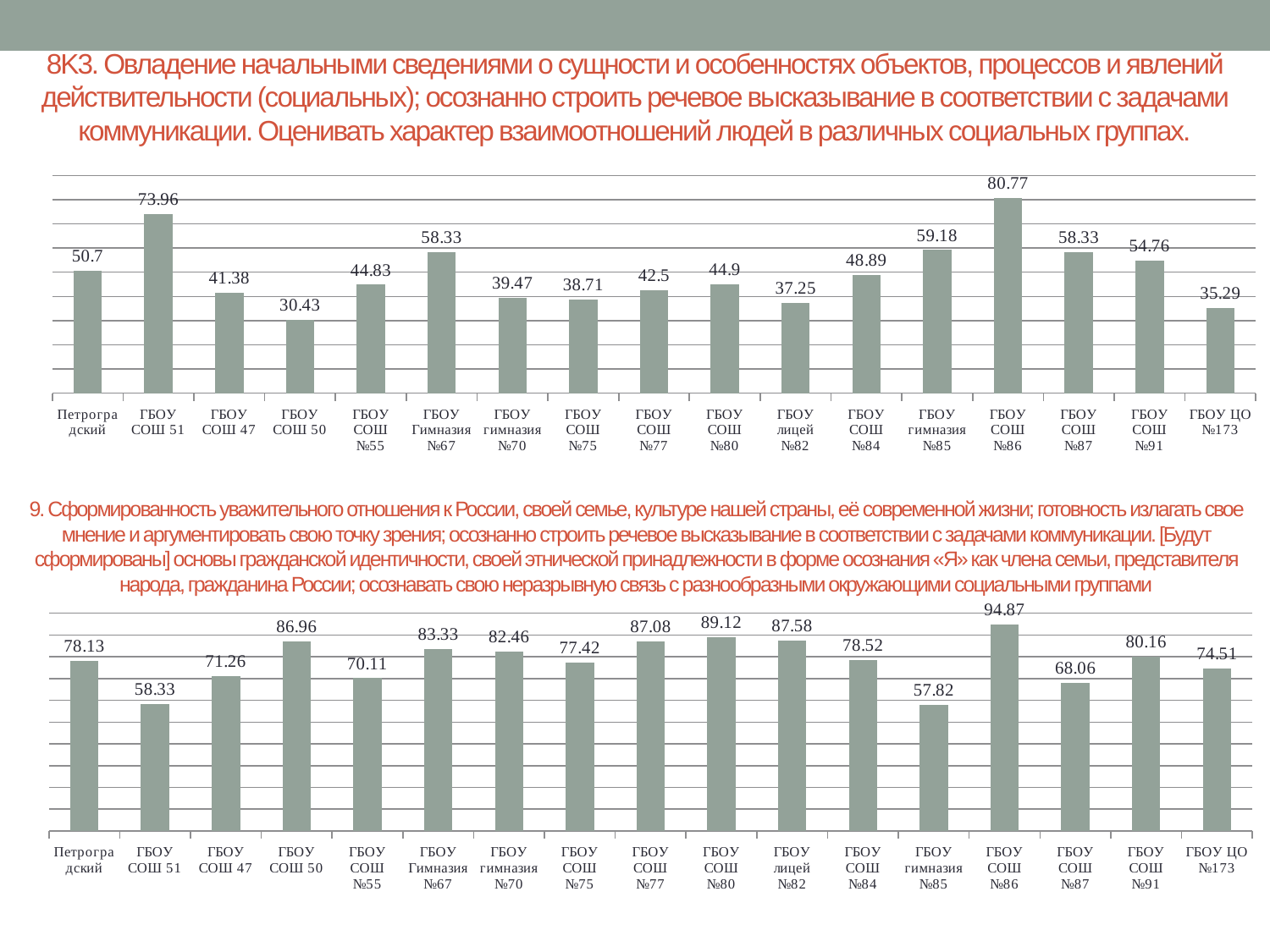
In the bottom chart, which category has the highest value? ГБОУ СОШ №86 In the top chart, which category has the lowest value? ГБОУ СОШ 50 In the top chart, what is the value for Петроградский? 50.7 What type of chart is the top chart? Bar chart In the top chart, what is the value for ГБОУ СОШ №86? 80.77 In the bottom chart, what is the difference between the values for ГБОУ СОШ №86 and ГБОУ СОШ №87? 26.81 How many categories are shown in the bottom chart? 17 In the top chart, what is the difference between the values for ГБОУ СОШ 51 and ГБОУ СОШ 47? 32.58 In the bottom chart, what is the value for ГБОУ СОШ №80? 89.12 In the top chart, which category has the highest value? ГБОУ СОШ №86 In the bottom chart, which category has the lowest value? ГБОУ гимназия №85 In the top chart, which is larger: the value for ГБОУ гимназия №85 or the value for ГБОУ СОШ №91? ГБОУ гимназия №85